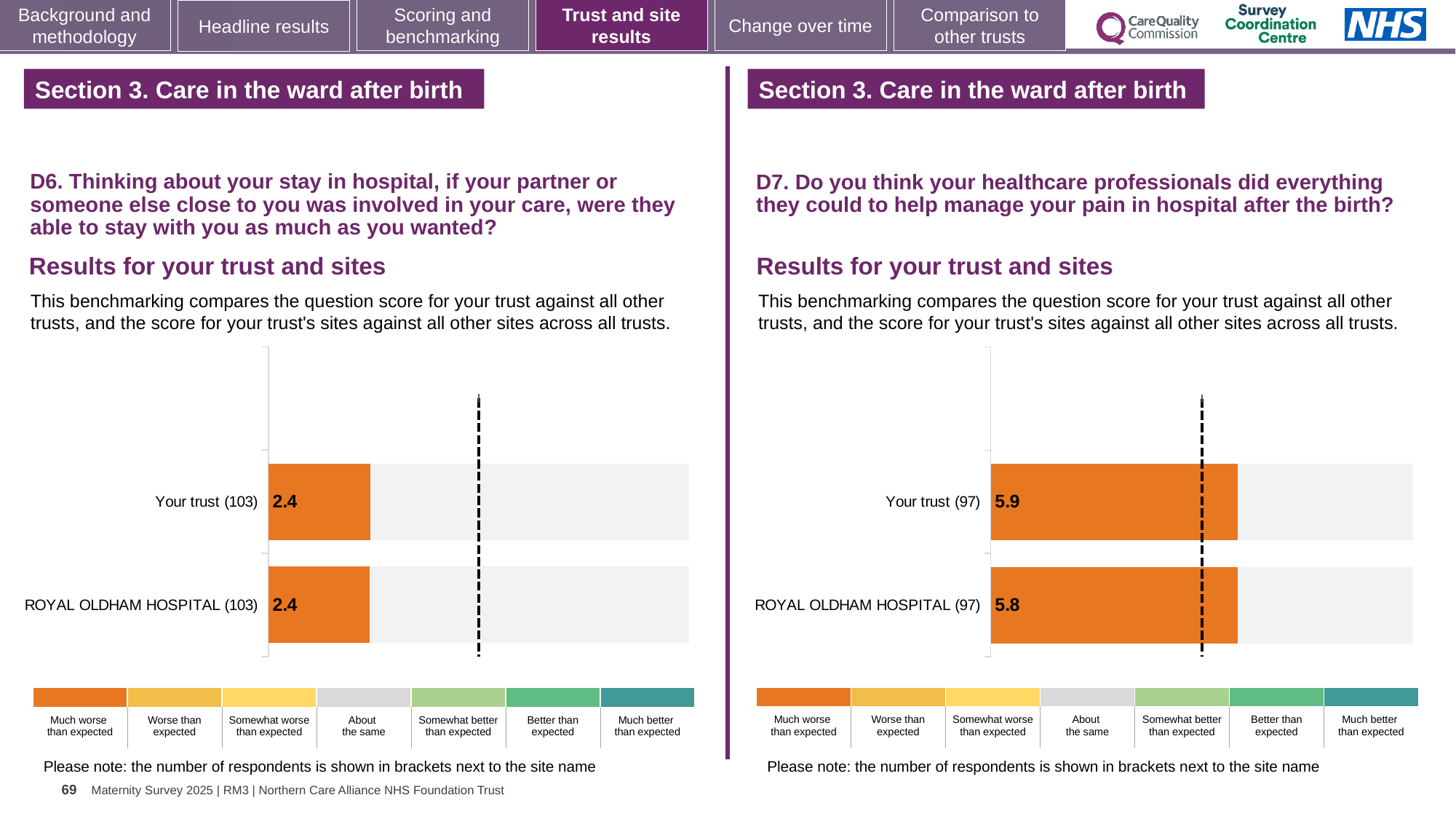
In the D7 chart on the right, what is the score for ROYAL OLDHAM HOSPITAL? 5.8 In the D6 chart on the left, what is the score for Your trust? 2.4 How many bars are plotted in the D6 chart on the left? 2 In the D6 chart on the left, what is the score for ROYAL OLDHAM HOSPITAL? 2.4 What type of chart is used in the D6 chart on the left? Bar chart In the D6 chart on the left, what is the difference between the score for Your trust and the score for ROYAL OLDHAM HOSPITAL? 0 In the D7 chart on the right, which has the higher score, Your trust or ROYAL OLDHAM HOSPITAL? Your trust In the D6 chart on the left, how many respondents are shown in brackets next to Your trust? 103 In the D7 chart on the right, how many respondents are shown in brackets next to ROYAL OLDHAM HOSPITAL? 97 In the D7 chart on the right, what is the score for Your trust? 5.9 How many bars are plotted in the D7 chart on the right? 2 In the D7 chart on the right, what is the difference between the score for Your trust and the score for ROYAL OLDHAM HOSPITAL? 0.1